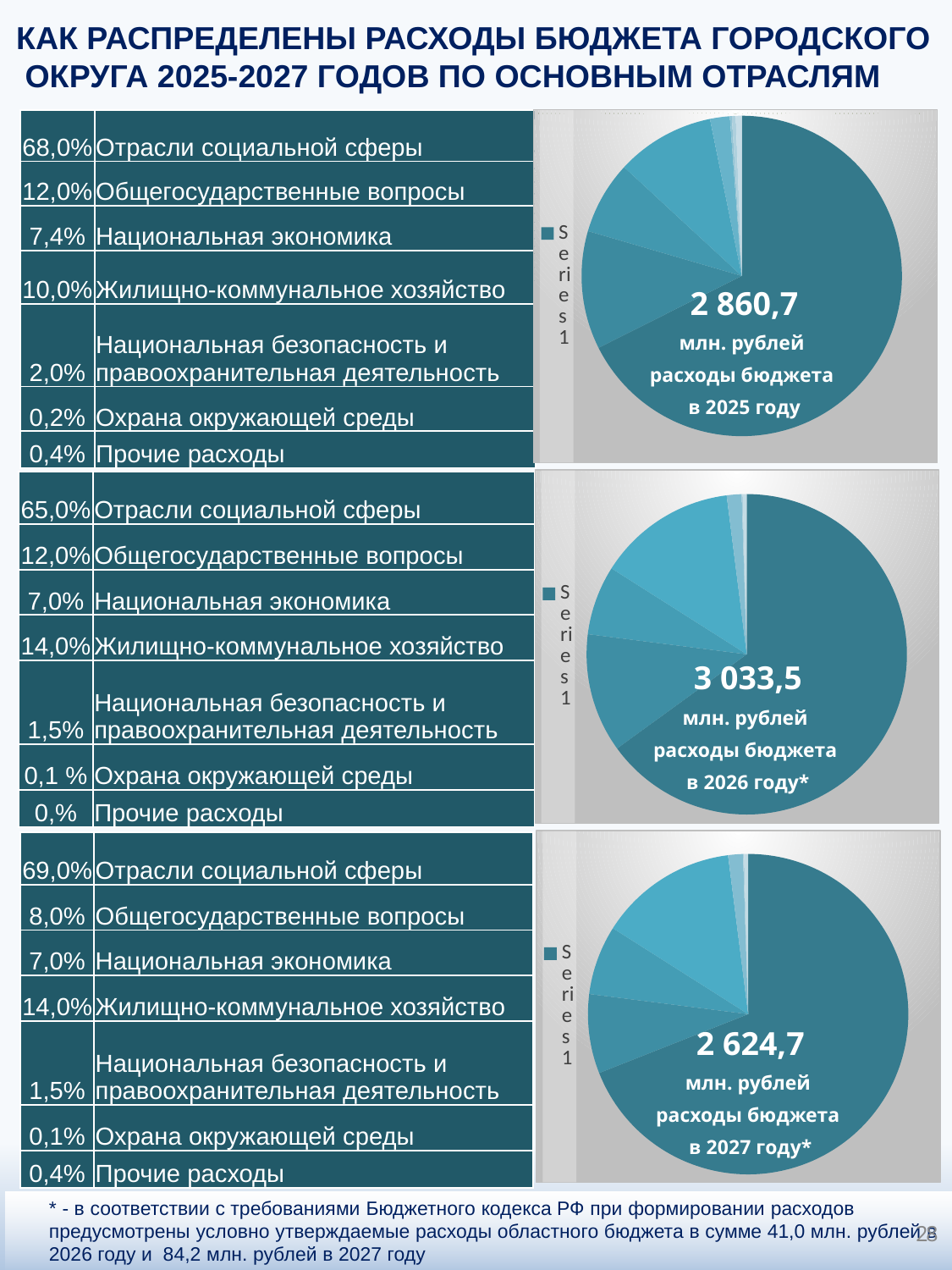
What total expenditure is printed in the centre of the 2025 pie chart? 2 860,7 млн. рублей In the 2025 chart, which category has the smallest share of expenditure? Охрана окружающей среды How many pie charts are on the slide? 3 What total expenditure is printed in the centre of the 2026 pie chart? 3 033,5 млн. рублей In the 2026 chart, what share of expenditure goes to Жилищно-коммунальное хозяйство? 14,0% In the 2027 chart, which category has the largest share of expenditure? Отрасли социальной сферы What kind of chart is used to show the 2025 budget expenditure distribution? pie chart What total expenditure is printed in the centre of the 2027 pie chart? 2 624,7 млн. рублей In the 2027 chart, what share of expenditure goes to Общегосударственные вопросы? 8,0% In the 2025 chart, what share of expenditure goes to Отрасли социальной сферы? 68,0% Which pie chart shows the larger total expenditure, 2026 or 2027? 2026 What legend entry is shown next to each pie chart? Series1